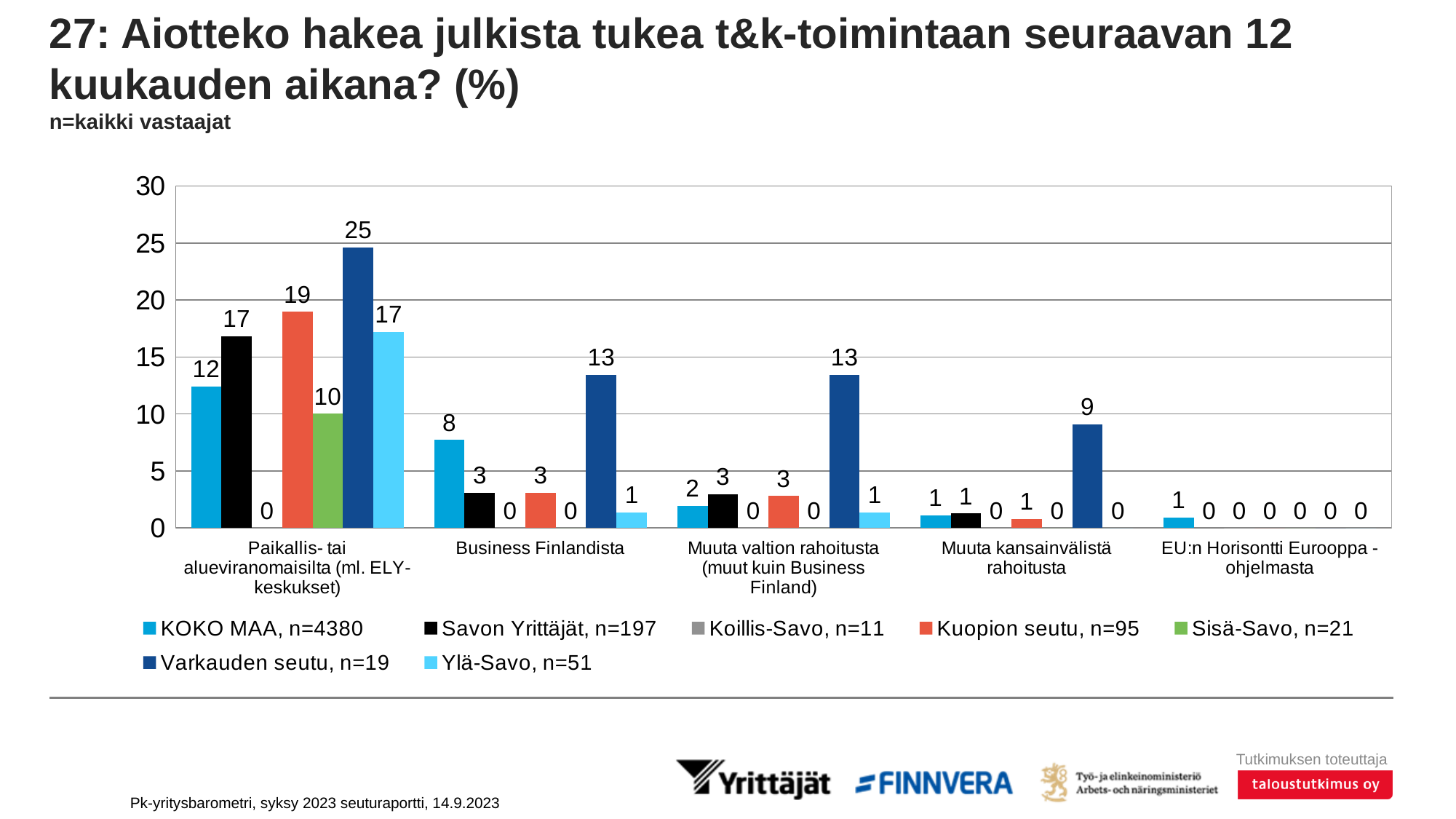
In the 'Business Finlandista' category, which is larger: the value for KOKO MAA or the value for Savon Yrittäjät? KOKO MAA What is the value for Varkauden seutu in the 'Paikallis- tai alueviranomaisilta (ml. ELY-keskukset)' category? 25 What is the value for KOKO MAA in the 'Business Finlandista' category? 8 What is the value for Kuopion seutu in the 'Paikallis- tai alueviranomaisilta (ml. ELY-keskukset)' category? 19 Which series has the highest value in the 'Business Finlandista' category? Varkauden seutu, n=19 How many categories are shown on the x axis? 5 What kind of chart is shown on the slide? Bar chart Which series has the highest value in the 'Muuta kansainvälistä rahoitusta' category? Varkauden seutu, n=19 What is the difference between the Varkauden seutu and KOKO MAA values in the 'Paikallis- tai alueviranomaisilta (ml. ELY-keskukset)' category? 13 What is the value for Varkauden seutu in the 'Muuta valtion rahoitusta (muut kuin Business Finland)' category? 13 What is the value for Sisä-Savo in the 'Paikallis- tai alueviranomaisilta (ml. ELY-keskukset)' category? 10 How many series does the legend list? 7